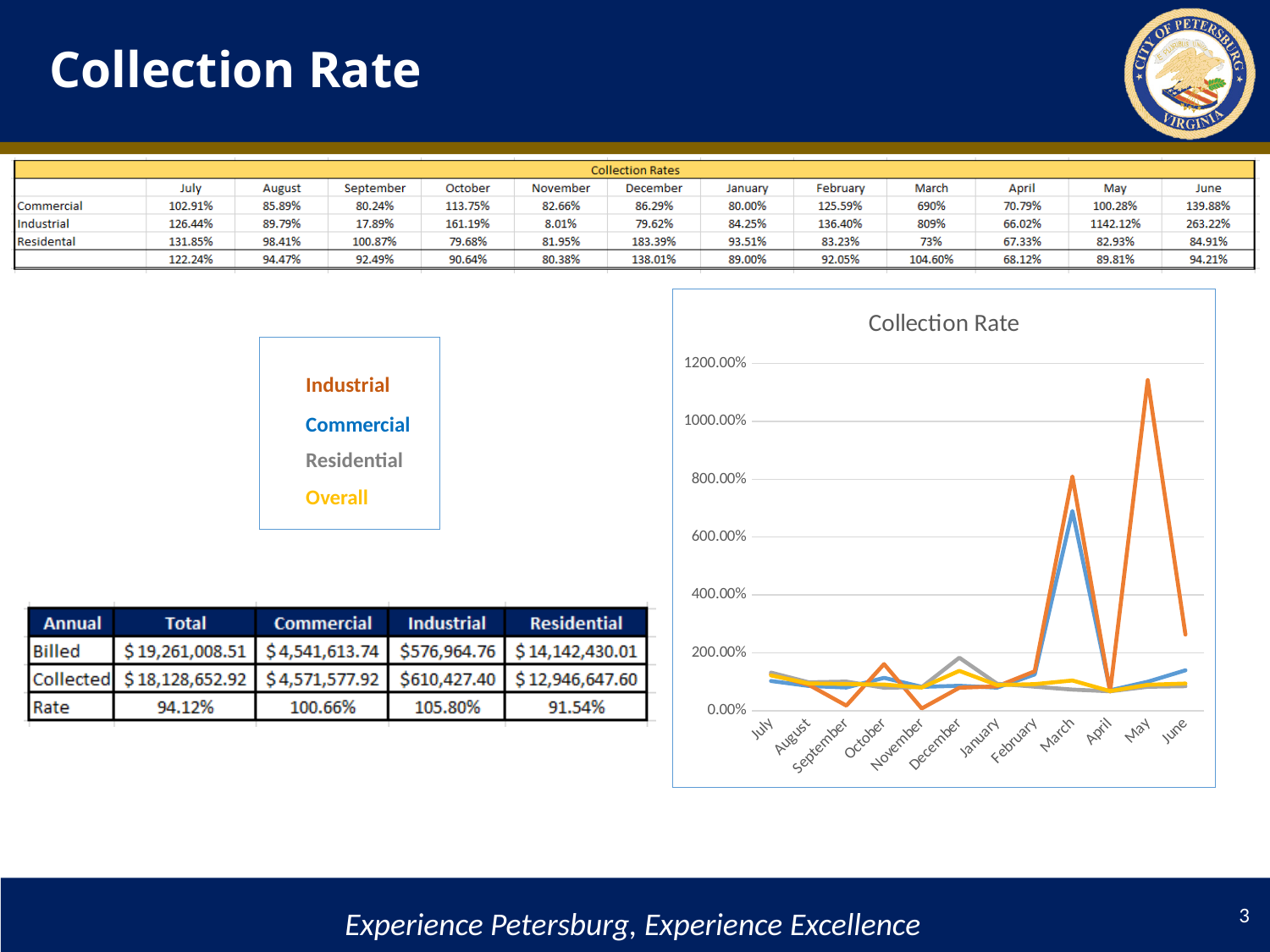
According to the Collection Rates table, what is the Industrial collection rate for May? 1142.12% According to the Collection Rates table, what is the Commercial collection rate for March? 690% In the "Collection Rate" chart, which is higher in March, the Industrial line or the Commercial line? Industrial What colour is the Industrial line in the "Collection Rate" chart? orange In the "Collection Rate" chart, is the Commercial value for March greater or less than 600.00%? greater In the "Collection Rate" chart, which month has the highest Industrial value? May How many months are plotted along the x axis of the "Collection Rate" chart? 12 What kind of chart is the "Collection Rate" chart? line chart In the "Collection Rate" chart, is the Industrial value for May greater or less than 1000.00%? greater How many series does the legend box next to the "Collection Rate" chart list? 4 In the "Collection Rate" chart, is the Industrial value for April greater or less than 200.00%? less In the "Collection Rate" chart, does the Industrial line rise or fall from March to April? fall